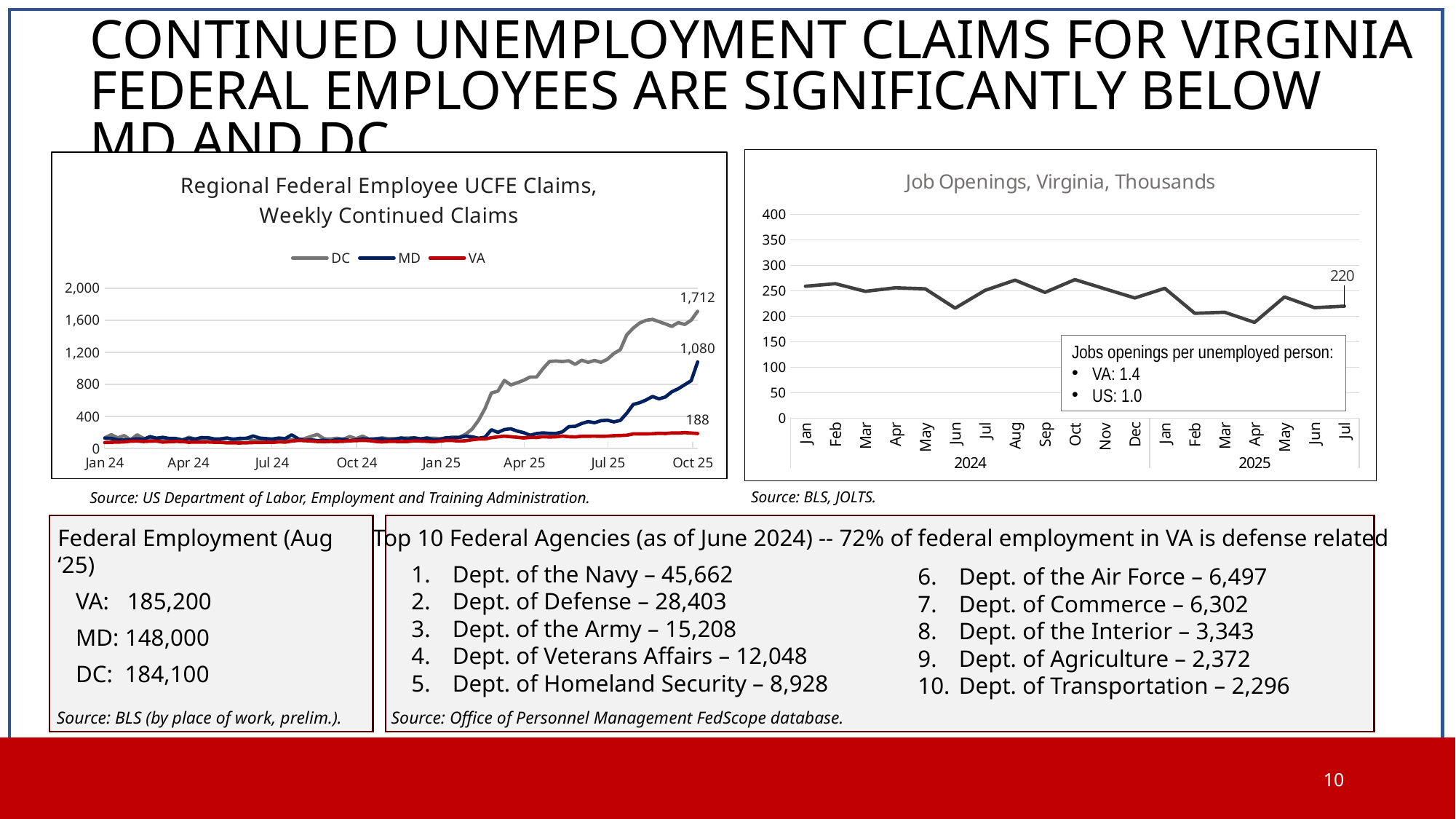
What kind of chart is 'Regional Federal Employee UCFE Claims, Weekly Continued Claims'? Line chart In the 'Job Openings, Virginia, Thousands' chart, is the value for Apr 2025 greater or less than 200? less In the 'Job Openings, Virginia, Thousands' chart, what is the labelled value for Jul 2025? 220 In the 'Regional Federal Employee UCFE Claims, Weekly Continued Claims' chart, which series has the lowest final labelled value? VA In the 'Regional Federal Employee UCFE Claims, Weekly Continued Claims' chart, does the DC series rise or fall between Jan 25 and Oct 25? Rise In the 'Regional Federal Employee UCFE Claims, Weekly Continued Claims' chart, how many series does the legend list? 3 In the 'Regional Federal Employee UCFE Claims, Weekly Continued Claims' chart, which series has the highest final labelled value? DC In the 'Regional Federal Employee UCFE Claims, Weekly Continued Claims' chart, what is the final labelled value for DC? 1,712 In the 'Regional Federal Employee UCFE Claims, Weekly Continued Claims' chart, what is the final labelled value for MD? 1,080 In the 'Regional Federal Employee UCFE Claims, Weekly Continued Claims' chart, what is the difference between the final labelled values for DC and MD? 632 In the 'Regional Federal Employee UCFE Claims, Weekly Continued Claims' chart, what is the final labelled value for VA? 188